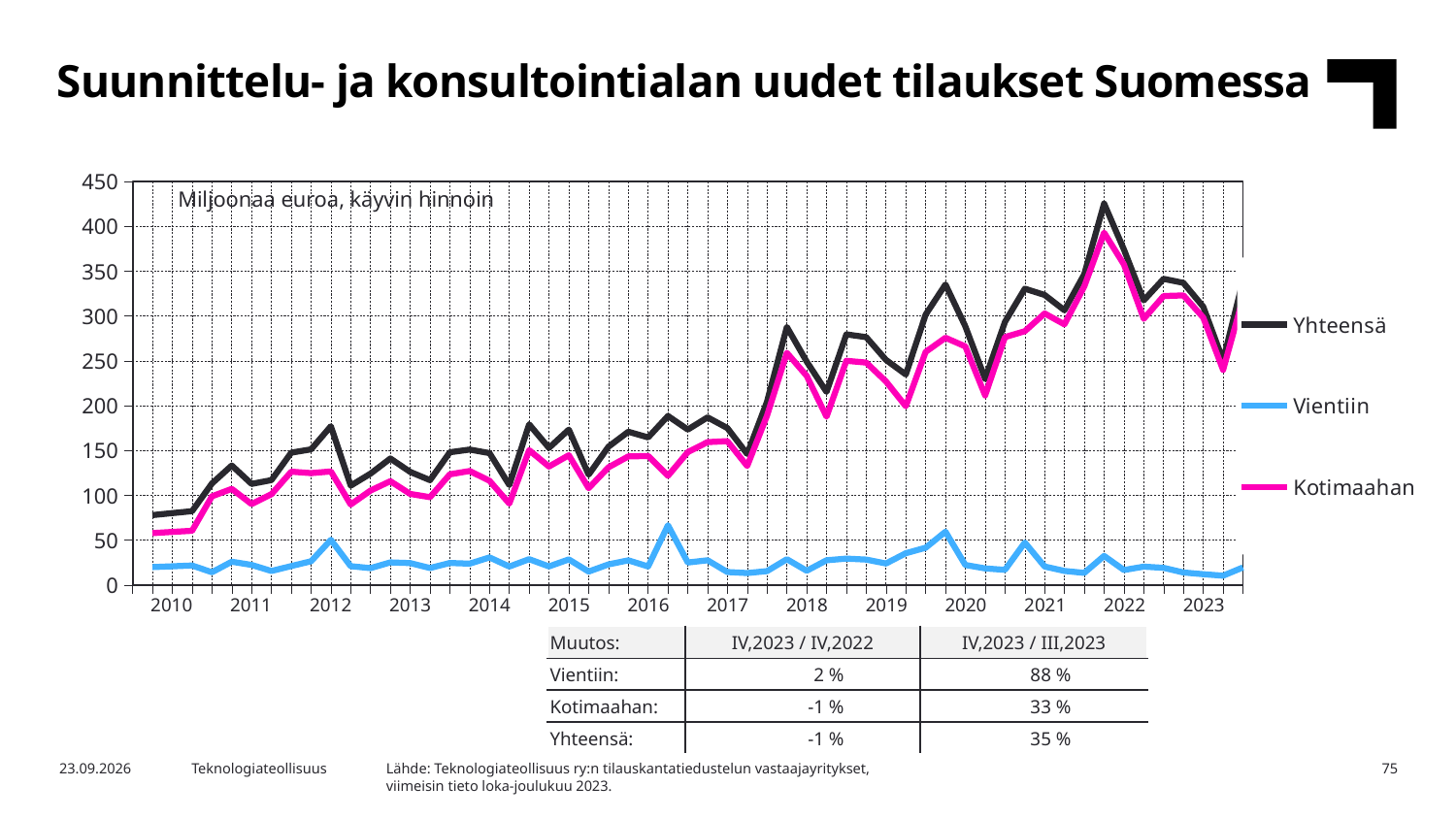
What unit is stated inside the chart area? Miljoonaa euroa, käyvin hinnoin Does the Yhteensä series overall rise or fall from 2010 to 2023? rise Which series is shown with the blue line? Vientiin Is the value of Yhteensä at the start of 2010 greater or less than 100? less Which series has the highest values throughout the chart? Yhteensä Is the peak value of Yhteensä in late 2021 greater or less than 400? greater How many years are labelled on the x axis? 14 According to the table below the chart, what is the change for Vientiin in IV,2023 / III,2023? 88 % How many series does the chart legend list? 3 What kind of chart is shown on the slide? Line chart Is the peak value of Kotimaahan in late 2021 greater or less than 350? greater Which series has the lowest values throughout the chart? Vientiin